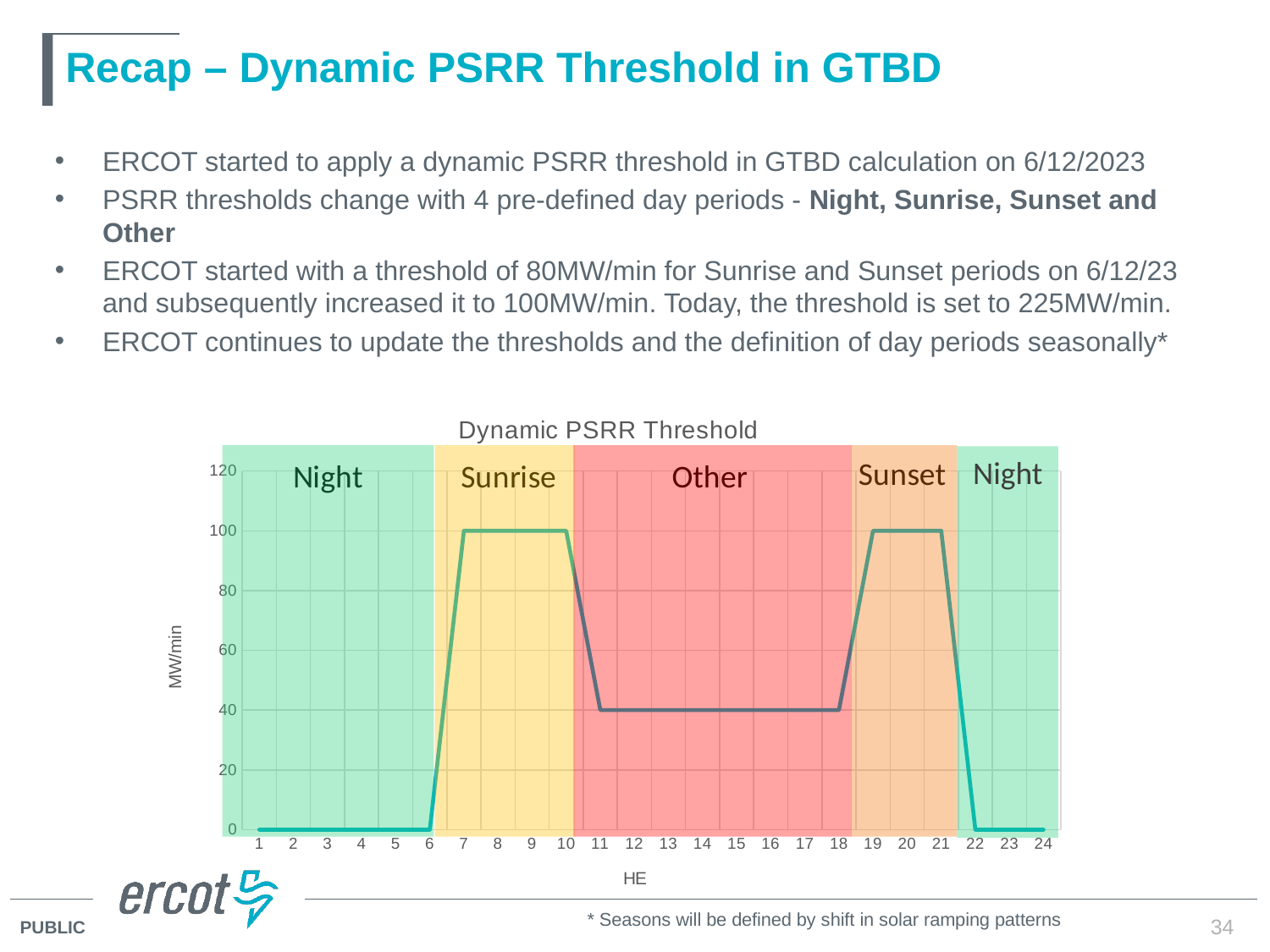
Is the value of the line at HE 16 greater or less than 60? less What is the label of the y axis of the chart? MW/min What is the difference between the line value at HE 9 and the line value at HE 15? 60 How many hour-ending (HE) points are shown on the x axis of the chart? 24 What is the value of the line at HE 20? 100 What is the title of the chart? Dynamic PSRR Threshold What is the value of the line at HE 3? 0 What is the value of the line at HE 8? 100 What is the value of the line at HE 14? 40 What kind of chart is shown on the slide? line chart Does the line rise or fall between HE 10 and HE 11? fall Which is larger, the line value at HE 12 or the line value at HE 23? HE 12